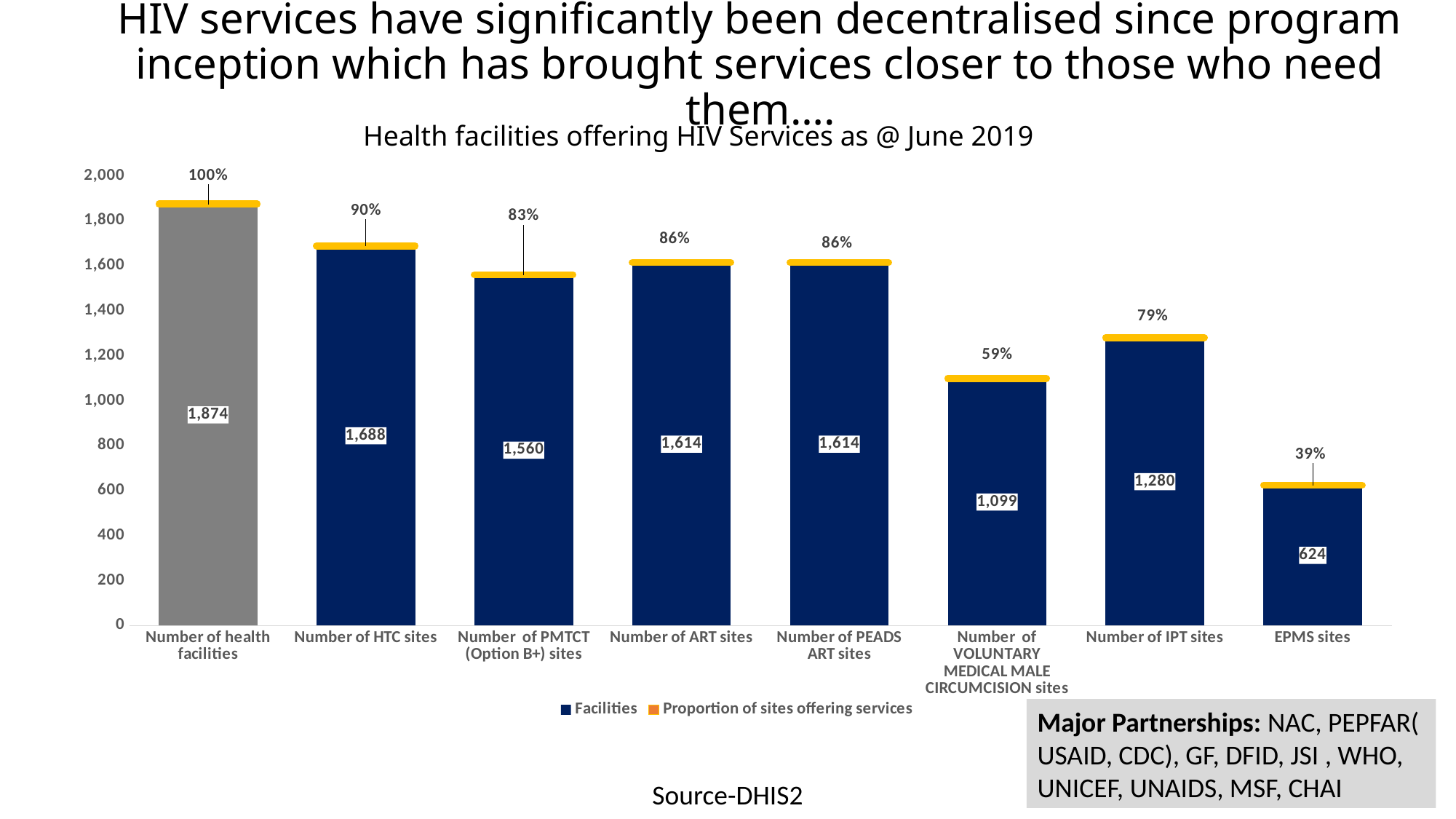
What kind of chart is this? Bar chart How many categories are shown on the x axis? 8 What is the number of HTC sites shown on the chart? 1,688 What is the difference between the number of health facilities and the number of HTC sites? 186 Which is larger, the number of PMTCT (Option B+) sites or the number of ART sites? Number of ART sites How many series does the legend list? 2 What proportion of sites offer services for EPMS sites? 39% Which category has the lowest number of facilities? EPMS sites Which category has the highest number of facilities? Number of health facilities What is the title of the chart? Health facilities offering HIV Services as @ June 2019 What proportion of sites offer services for the Number of VOLUNTARY MEDICAL MALE CIRCUMCISION sites? 59% What is the number of IPT sites? 1,280